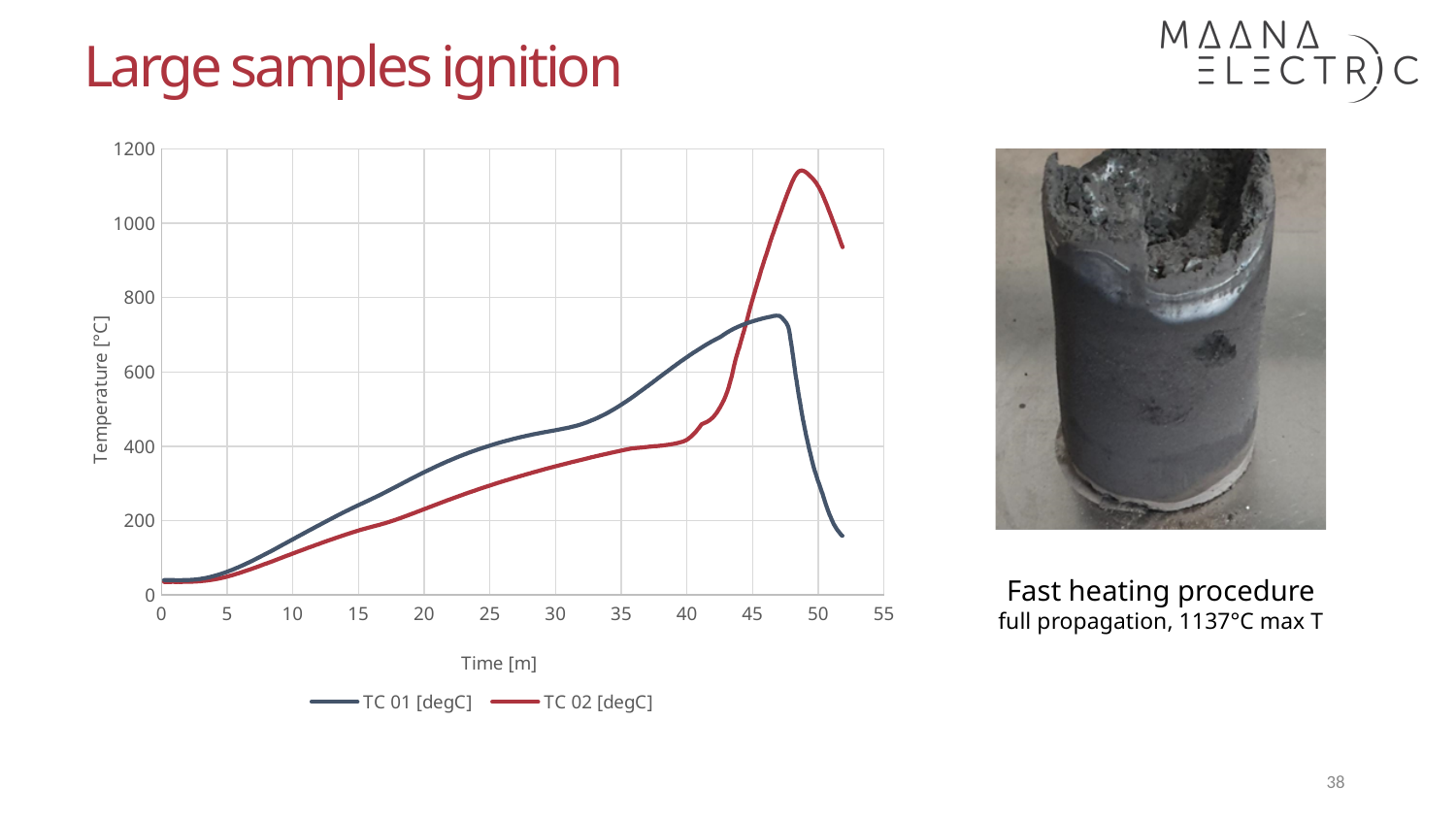
Which series reaches the higher peak temperature, TC 01 or TC 02? TC 02 Is the peak value of TC 01 greater or less than 800? less Is the peak value of TC 02 greater or less than 1000? greater Is the value of TC 02 at 30 minutes greater or less than 400? less How many series does the chart legend list? 2 What kind of chart is shown on the slide? line chart At 30 minutes, which series has the higher temperature, TC 01 or TC 02? TC 01 Does the TC 02 series rise or fall between 0 and 45 minutes? rise At 45 minutes, which series has the higher temperature, TC 01 or TC 02? TC 02 What are the two series named in the chart legend? TC 01 [degC] and TC 02 [degC] What is the label of the vertical axis of the chart? Temperature [°C]